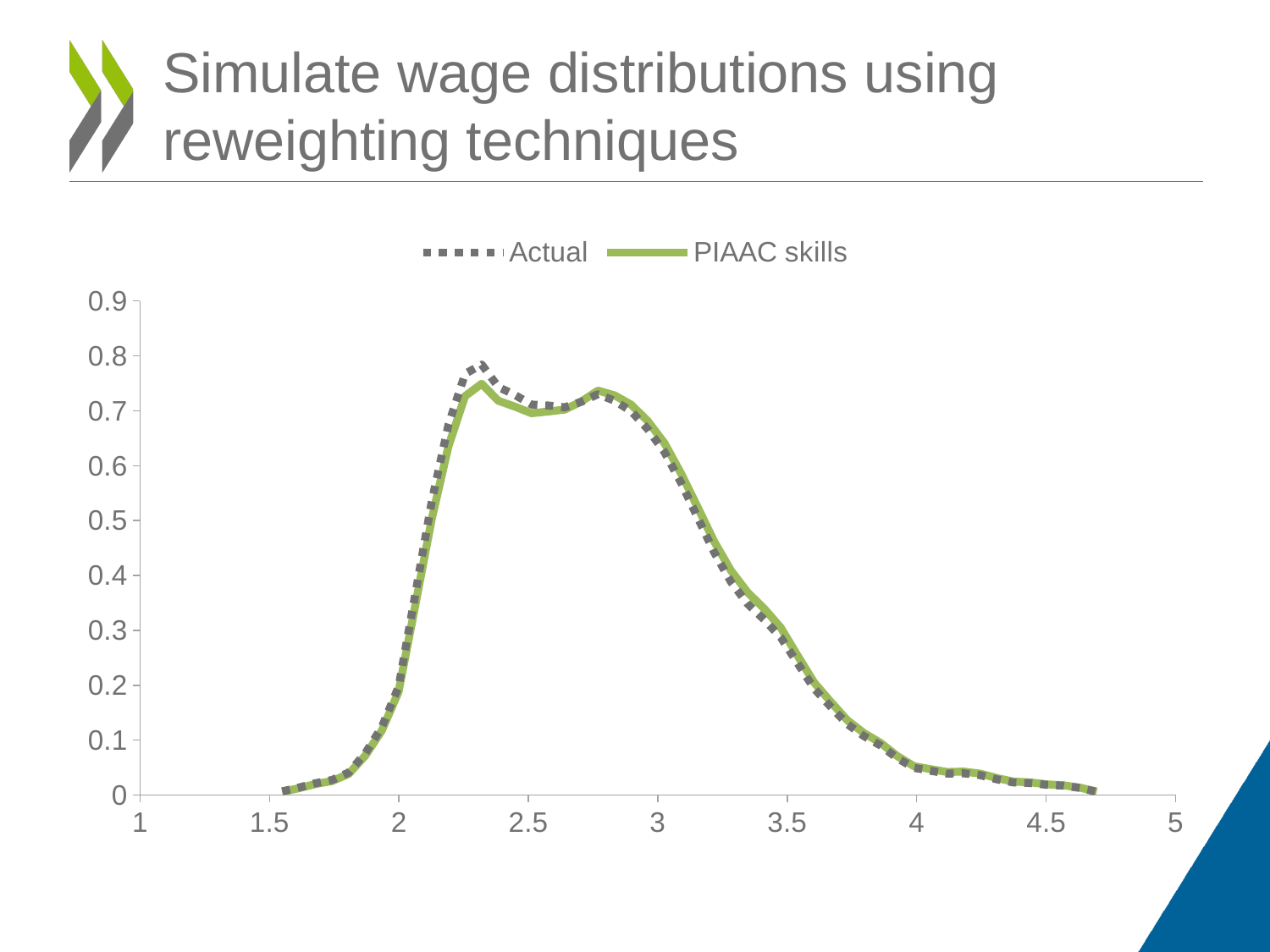
Which series is drawn as a dashed grey line? Actual Is the value of the Actual series at x = 3.5 greater or less than 0.4? less What are the two series named in the legend? Actual and PIAAC skills Is the value of the Actual series at x = 2 greater or less than 0.3? less Which series reaches the higher peak value, Actual or PIAAC skills? Actual What kind of chart is shown on the slide? line chart Do the values of the PIAAC skills series rise or fall as x increases from 3 to 4.5? fall How many series does the legend list? 2 Is the value of the PIAAC skills series at x = 3 greater or less than 0.6? greater Do the values of the Actual series rise or fall as x increases from 1.5 to 2.3? rise